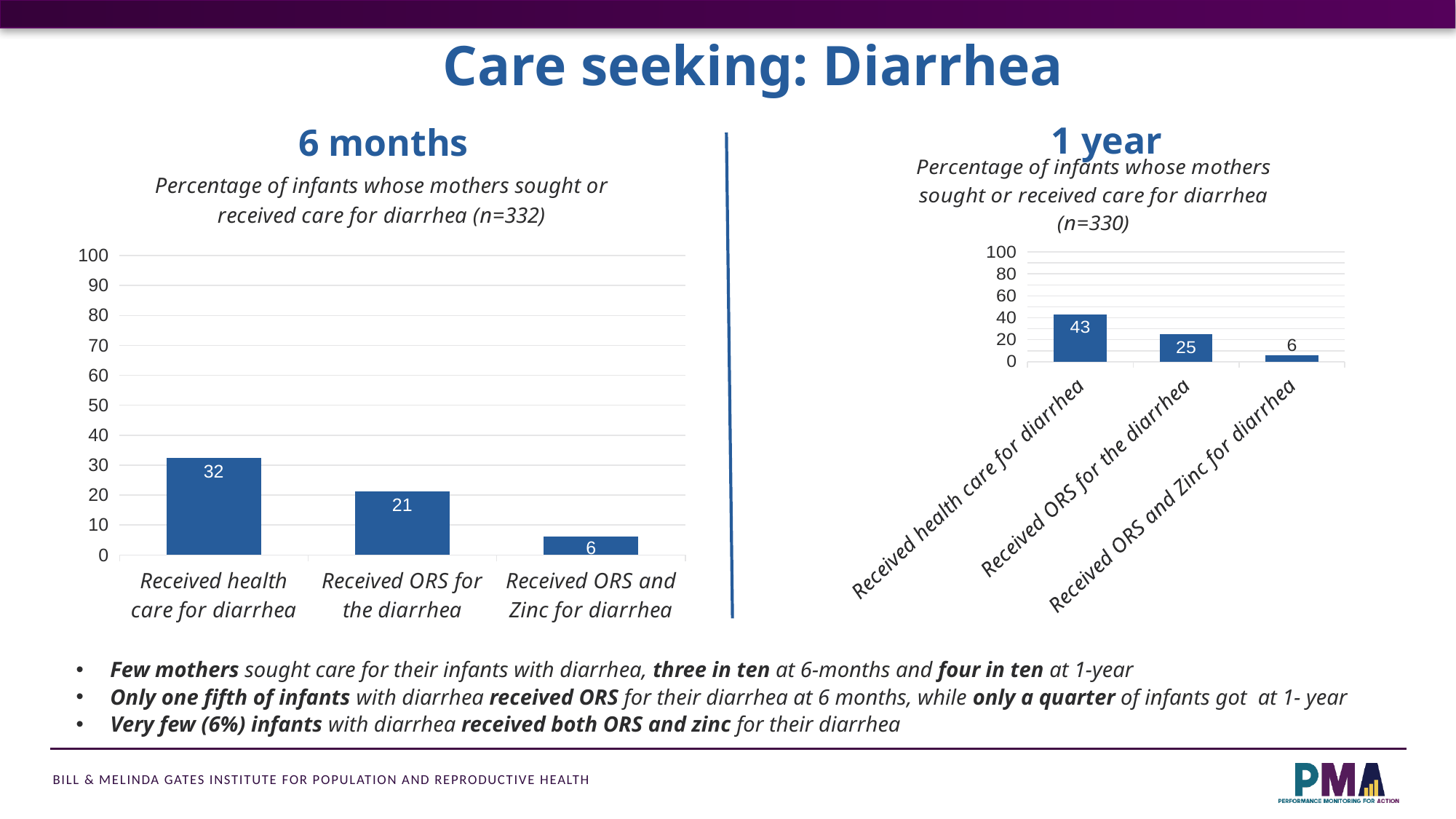
What type of chart is the 6 months chart? Bar chart In the 6 months chart, do the values rise or fall from left to right across the categories? Fall In the 1 year chart, what is the difference between 'Received health care for diarrhea' and 'Received ORS for the diarrhea'? 18 In the 6 months chart, what is the difference between 'Received ORS for the diarrhea' and 'Received ORS and Zinc for diarrhea'? 15 How many categories are shown in the 1 year chart? 3 In the 1 year chart, which category has the lowest value? Received ORS and Zinc for diarrhea In the 1 year chart, what is the value for 'Received ORS and Zinc for diarrhea'? 6 In the 6 months chart, what is the value for 'Received health care for diarrhea'? 32 In the 6 months chart, which category has the highest value? Received health care for diarrhea Which is larger: 'Received health care for diarrhea' in the 6 months chart or in the 1 year chart? 1 year chart In the 6 months chart, what is the value for 'Received ORS for the diarrhea'? 21 In the 1 year chart, what is the value for 'Received health care for diarrhea'? 43